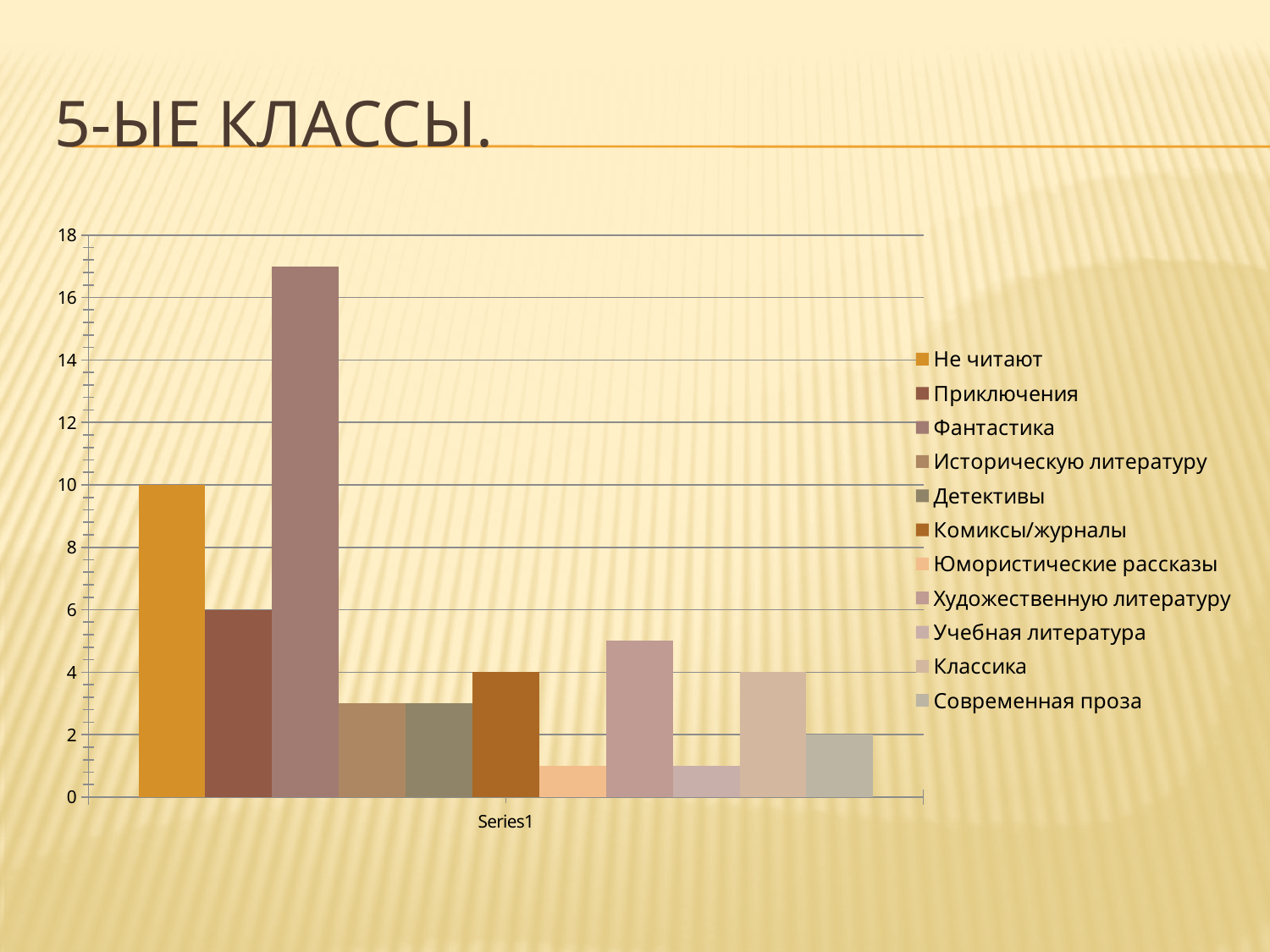
What is the value for Приключения? 6 What kind of chart is shown on the slide? bar chart What is the value for Комиксы/журналы? 4 Is the value for Художественную литературу greater or less than 4? greater Is the value for Фантастика greater or less than 16? greater What is the difference between the values for Не читают and Приключения? 4 What is the value for Не читают? 10 How many series does the legend list? 11 What is the title of the slide? 5-ые классы. Which series has the highest bar? Фантастика Which is larger, the value for Не читают or the value for Приключения? Не читают What is the value for Современная проза? 2